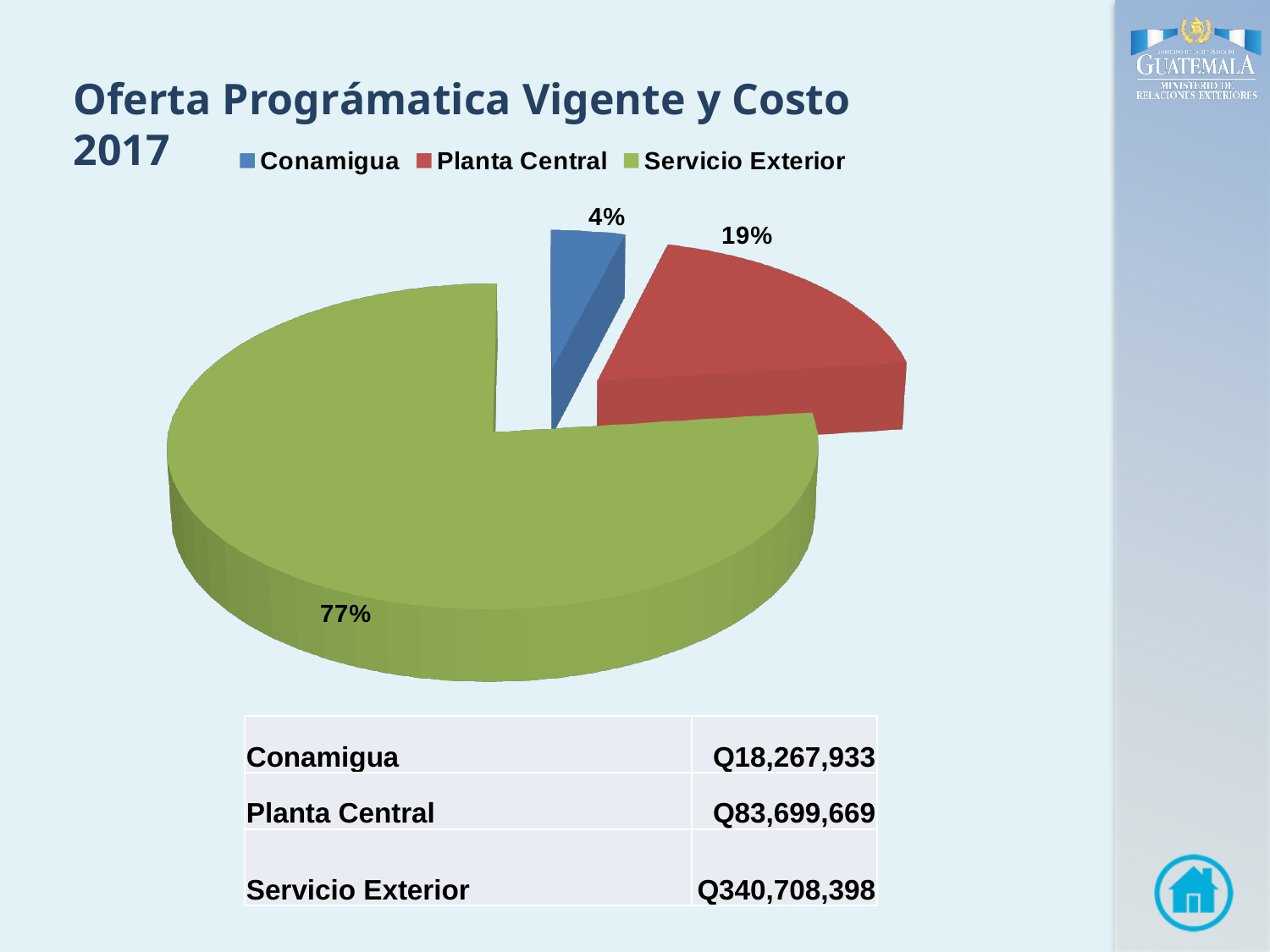
Which category has the smallest slice of the pie? Conamigua Which category has the largest slice of the pie? Servicio Exterior What is the difference in percentage points between the Servicio Exterior and Planta Central slices? 58 Which slice is larger, Planta Central or Conamigua? Planta Central What share of the pie does Servicio Exterior represent? 77% What kind of chart is shown on the slide? Pie chart How many entries does the legend list? 3 How many slices does the pie chart have? 3 What is the title of the slide containing the chart? Oferta Prográmatica Vigente y Costo 2017 What colour is the Servicio Exterior slice? Green What share of the pie does Planta Central represent? 19% What share of the pie does Conamigua represent? 4%